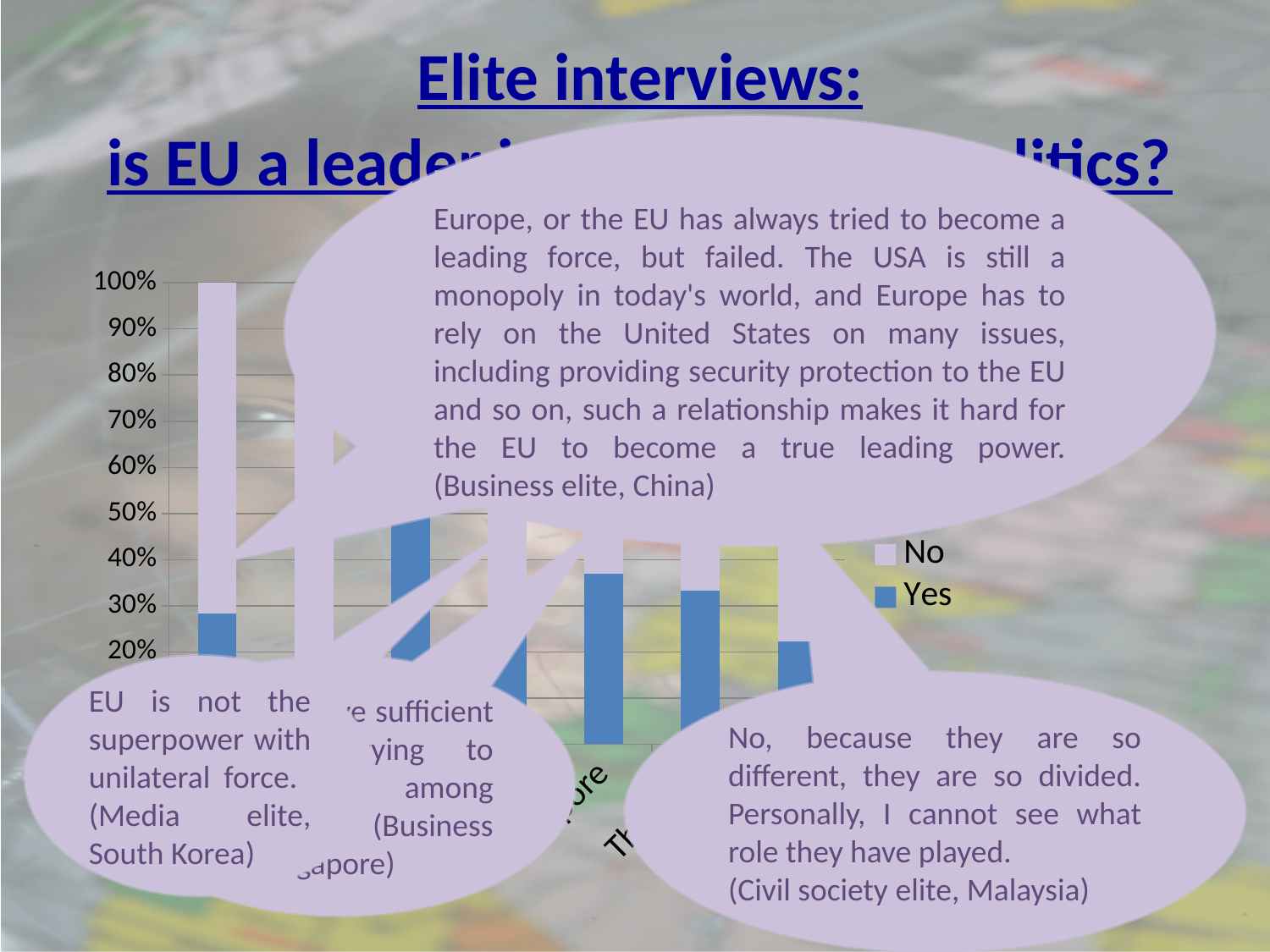
How many series does the chart's legend list? 2 What are the two entries in the chart's legend? No and Yes Which legend entry is shown in blue? Yes What kind of chart is shown on the slide? bar chart What is the highest value shown on the chart's vertical axis? 100%